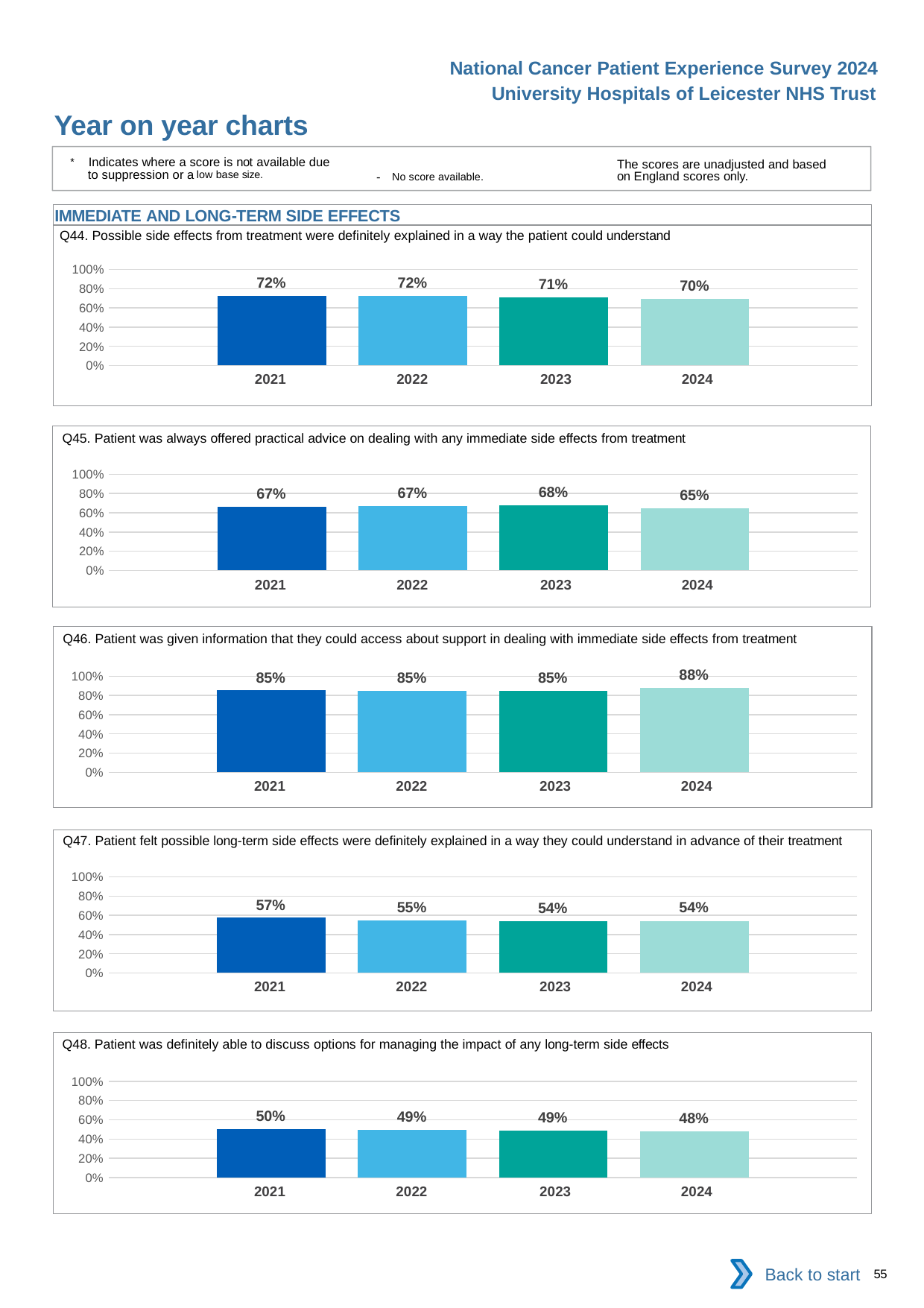
In the Q45 chart, which year has the highest value? 2023 In the Q46 chart, what is the difference between the 2024 value and the 2023 value? 3% How many bars are shown in the Q46 chart? 4 In the Q46 chart, what is the value for 2024? 88% How many charts are shown on the slide? 5 What type of chart is used for Q44? bar chart In the Q45 chart, is the value for 2024 larger or smaller than the value for 2021? smaller In the Q47 chart, what is the value for 2021? 57% In the Q48 chart, which year has the lowest value? 2024 In the Q48 chart, what is the difference between the 2021 value and the 2024 value? 2% In the Q47 chart, do the values rise or fall from 2021 to 2024? fall In the Q44 chart, what is the value for 2024? 70%